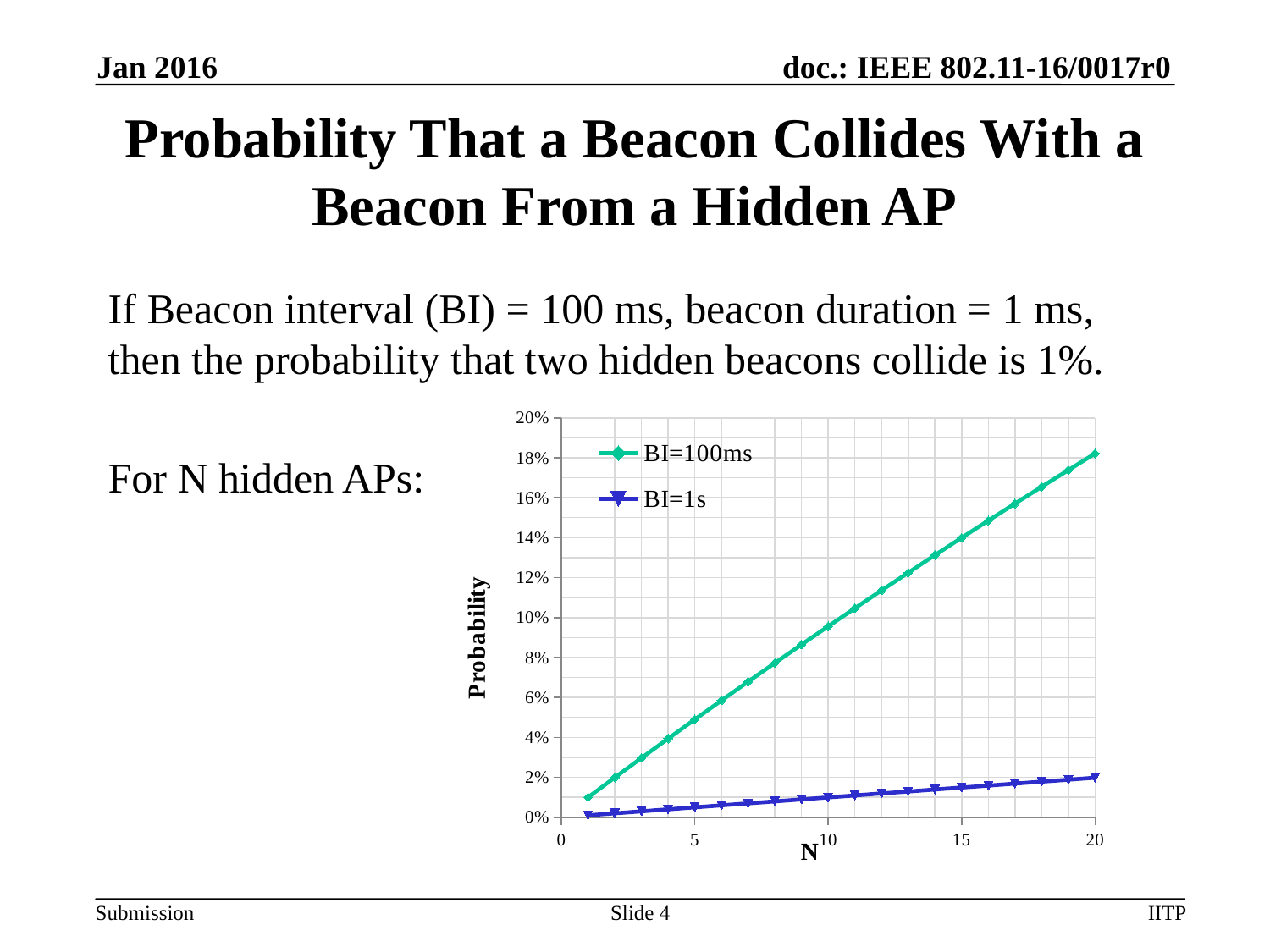
Is the probability for BI=1s at N=20 greater or less than 4%? less Which series reaches the highest probability on the chart? BI=100ms At which value of N does the BI=100ms series reach its highest probability? 20 Is the probability for BI=100ms at N=5 greater or less than 4%? greater How many series does the chart legend list? 2 Does the probability for the BI=100ms series rise or fall as N increases? rise Which series has the higher probability at N=10, BI=100ms or BI=1s? BI=100ms What are the two series named in the chart legend? BI=100ms and BI=1s Is the probability for BI=100ms at N=20 greater or less than 16%? greater What is the label of the chart's vertical axis? Probability What kind of chart is shown on the slide? line chart How many data points are plotted for the BI=100ms series? 20